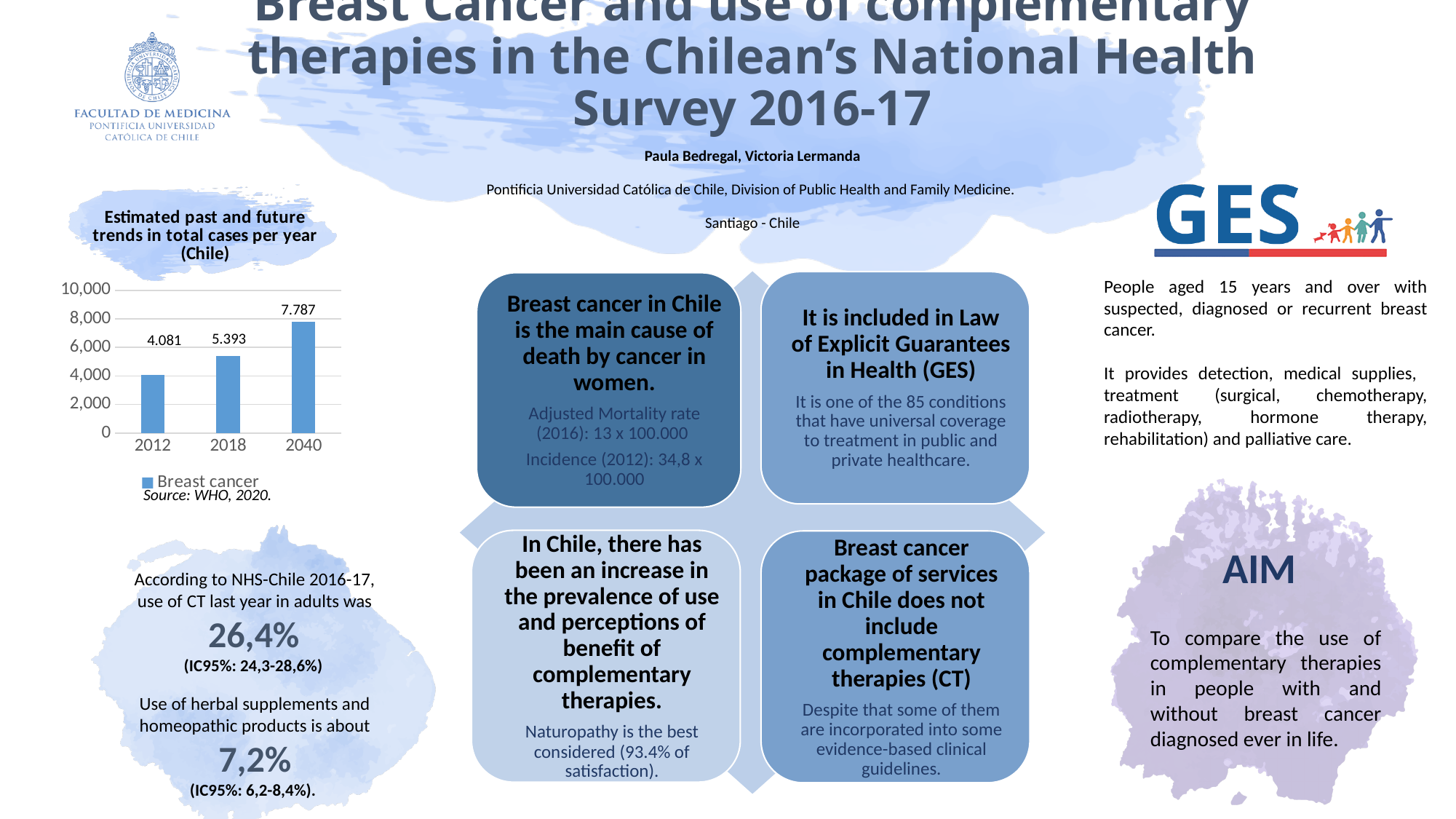
What is the value for 2018 in the chart? 5.393 Which is larger, the value for 2018 or the value for 2040? 2040 Is the value for 2040 greater or less than 6,000? greater What kind of chart is shown on the slide? bar chart What is the value for 2012 in the chart? 4.081 Which year has the highest value in the chart? 2040 What is the value for 2040 in the chart? 7.787 How many years are shown on the x axis of the chart? 3 What is the difference between the values for 2018 and 2012? 1.312 What is the difference between the values for 2040 and 2012? 3.706 Which year has the lowest value in the chart? 2012 Do the values rise or fall from 2012 to 2040? rise